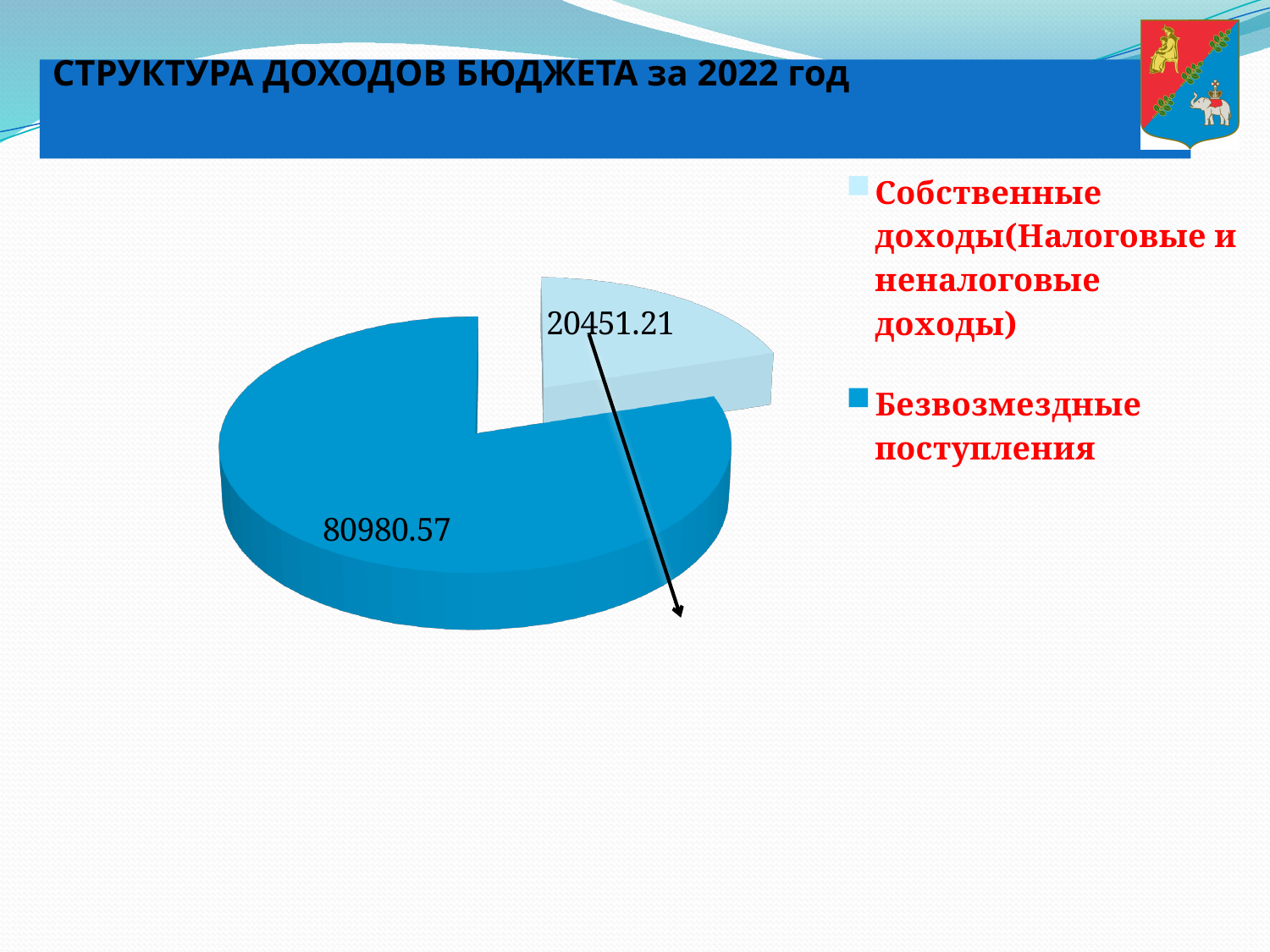
Which colour represents Собственные доходы in the legend? Light blue What is the value for Собственные доходы (Налоговые и неналоговые доходы)? 20451.21 How many categories does the pie chart have? 2 Which category has the smallest slice of the pie? Собственные доходы (Налоговые и неналоговые доходы) What is the value for Безвозмездные поступления? 80980.57 What type of chart is shown on the slide? Pie chart Which is larger: Безвозмездные поступления or Собственные доходы? Безвозмездные поступления What is the difference between Безвозмездные поступления and Собственные доходы? 60529.36 What is the title of the slide containing the chart? СТРУКТУРА ДОХОДОВ БЮДЖЕТА за 2022 год Which category has the largest slice of the pie? Безвозмездные поступления What is the total of the two values shown in the pie chart? 101431.78